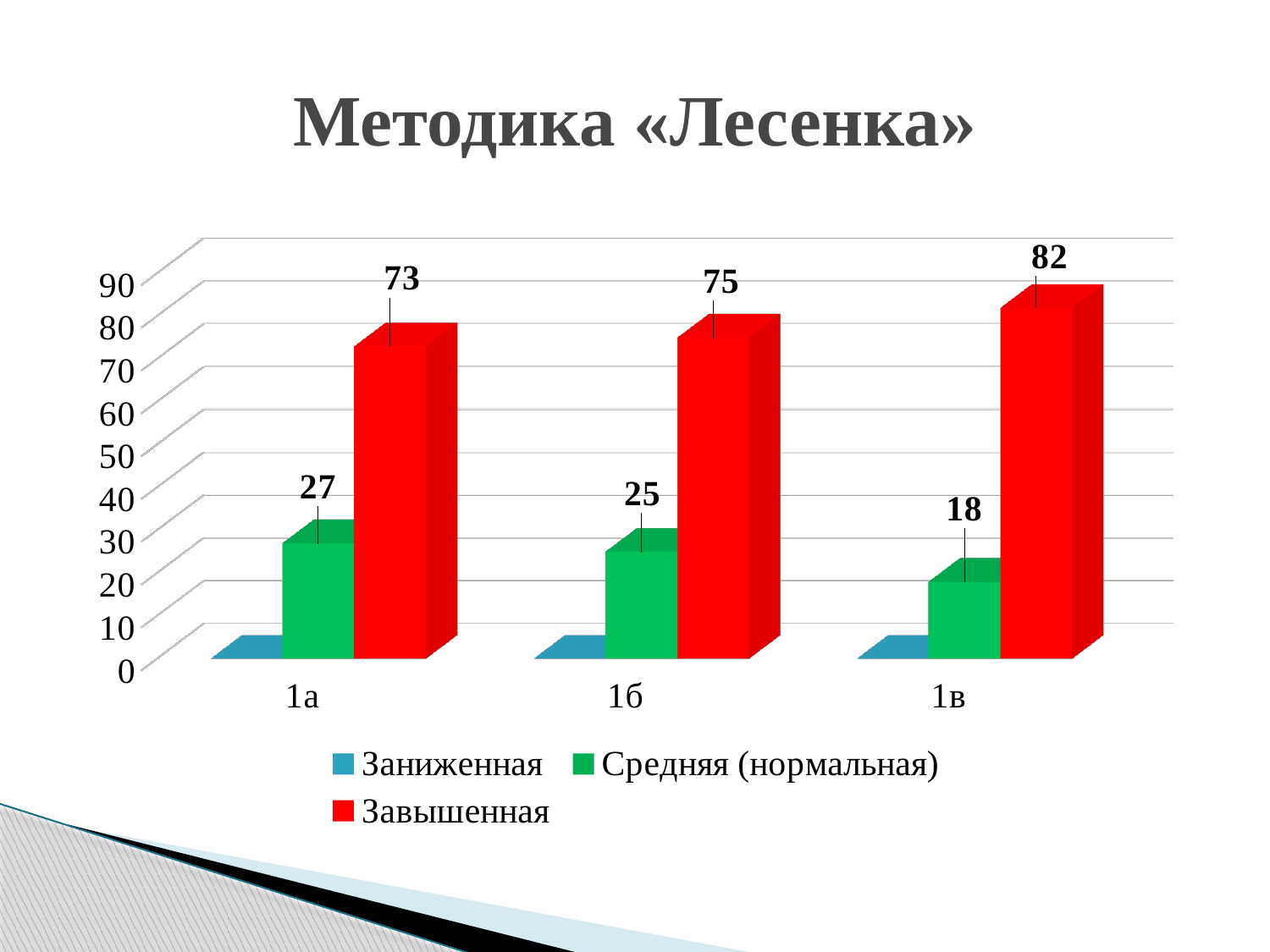
How many categories are shown on the x axis? 3 What is the value for Завышенная in category 1в? 82 Which is larger: the Средняя (нормальная) value for 1а or for 1б? 1а Which category has the lowest value for Средняя (нормальная)? 1в What is the title of the slide? Методика «Лесенка» What is the value for Завышенная in category 1б? 75 What kind of chart is shown on the slide? bar chart Which category has the highest value for Завышенная? 1в How many series does the legend list? 3 Is the value for Завышенная in 1а greater or less than 70? greater What is the difference between the Завышенная values for 1в and 1а? 9 What is the value for Средняя (нормальная) in category 1а? 27